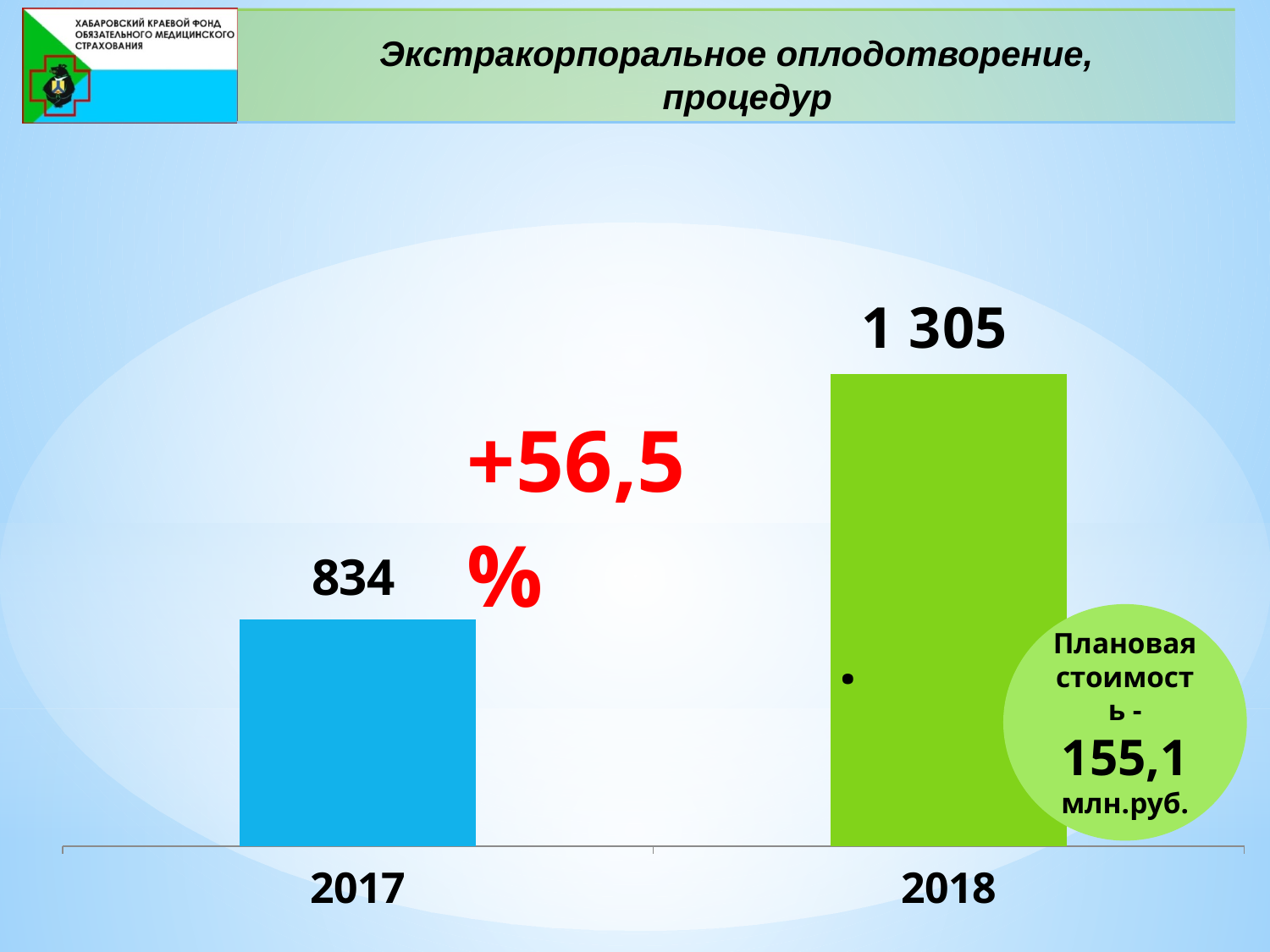
What percentage change is printed between the two bars? +56,5 % Which year has the lower value? 2017 Is the value for 2018 larger than the value for 2017? Yes What kind of chart is this? Bar chart What is the difference between the 2018 and 2017 values? 471 What is the value for 2018? 1 305 What is the title of the chart? Экстракорпоральное оплодотворение, процедур What is the value for 2017? 834 Do the values rise or fall from 2017 to 2018? Rise Which year has the higher value? 2018 How many categories are shown on the x axis? 2